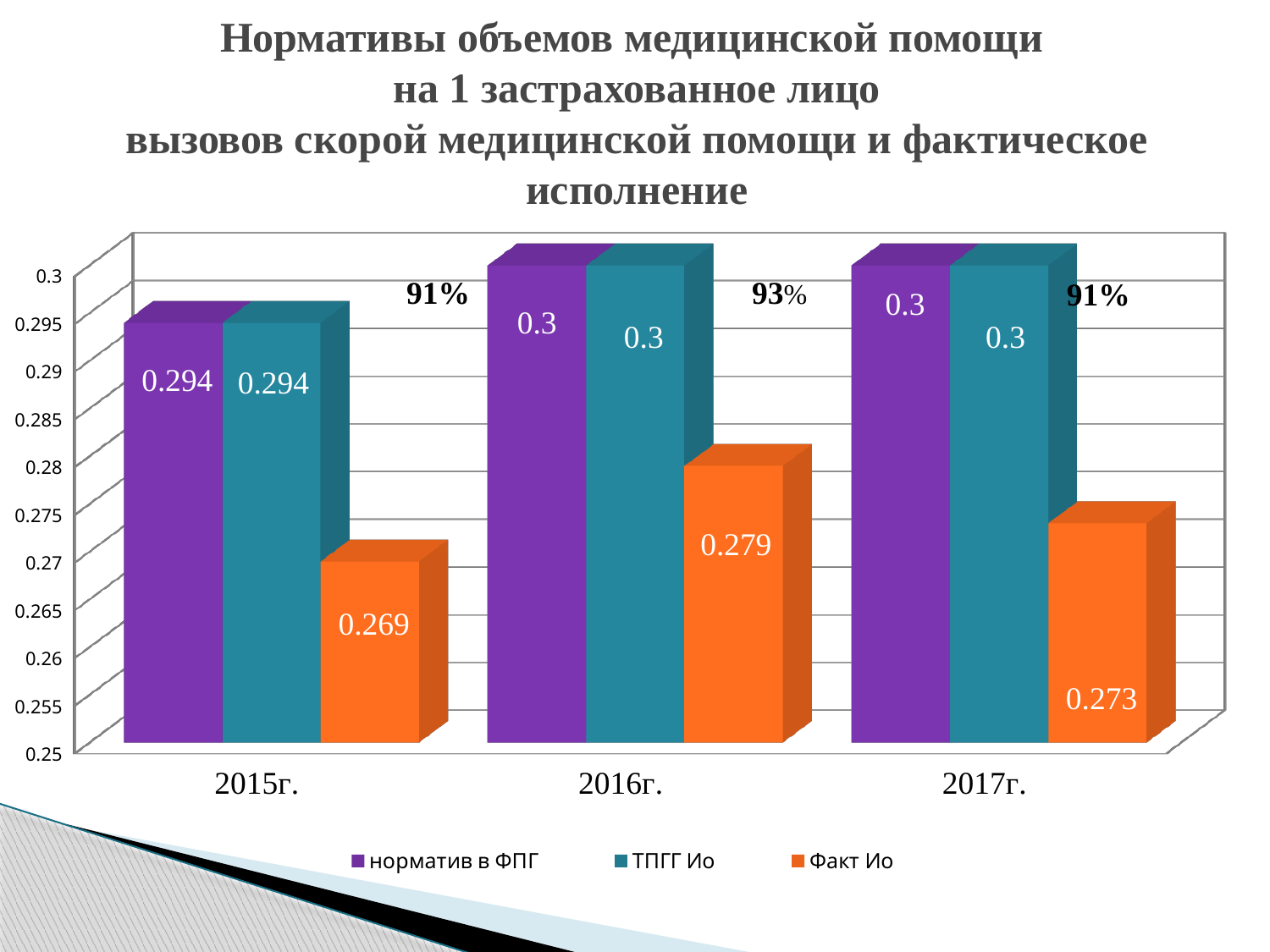
How many series does the legend list? 3 What is the value of норматив в ФПГ for 2015г.? 0.294 In which year is the Факт Ио value the lowest? 2015г. What percentage label is shown above the 2016г. group of bars? 93% What is the value of Факт Ио for 2015г.? 0.269 In which year is the Факт Ио value the highest? 2016г. What kind of chart is shown on the slide? bar chart How many years are shown on the x axis? 3 What is the difference between ТПГГ Ио and Факт Ио for 2017г.? 0.027 What is the value of Факт Ио for 2016г.? 0.279 What is the value of ТПГГ Ио for 2017г.? 0.3 Which is larger for 2016г.: норматив в ФПГ or Факт Ио? норматив в ФПГ